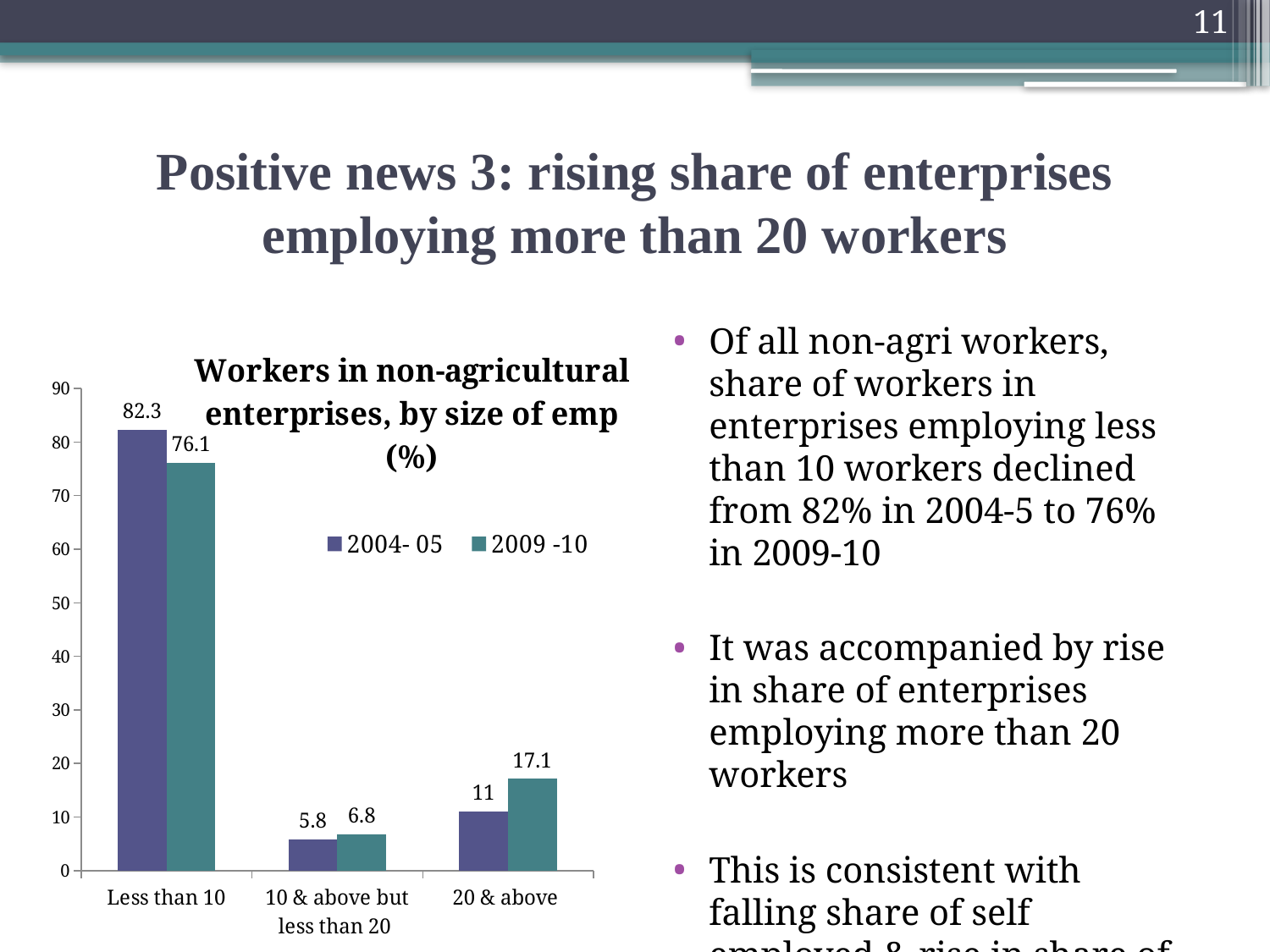
Which category has the highest value in the 2009 -10 series? Less than 10 What is the value for '20 & above' in the 2009 -10 series? 17.1 What kind of chart is shown on the slide? bar chart Is the 2009 -10 value for 'Less than 10' greater or less than 70? greater For '20 & above', which series has the larger value, 2004- 05 or 2009 -10? 2009 -10 How many series does the legend list? 2 How many categories are shown on the x axis? 3 What is the value for '10 & above but less than 20' in the 2004- 05 series? 5.8 What is the value for 'Less than 10' in the 2004- 05 series? 82.3 What is the difference between the 2009 -10 and 2004- 05 values for '20 & above'? 6.1 What is the difference between the 2004- 05 and 2009 -10 values for 'Less than 10'? 6.2 Which category has the lowest value in the 2004- 05 series? 10 & above but less than 20